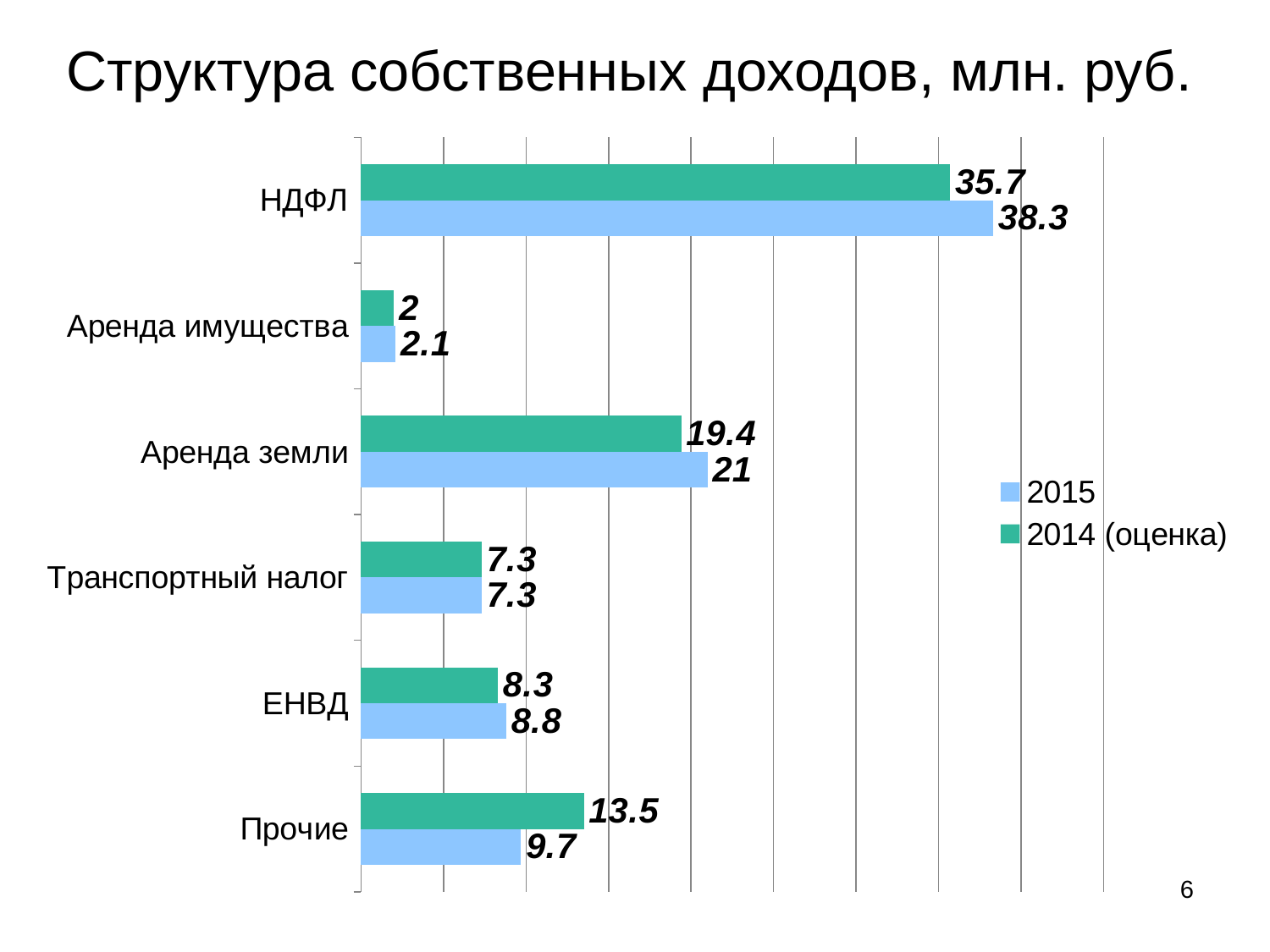
What is the difference between the 2014 (оценка) and 2015 values for Прочие? 3.8 What is the 2014 (оценка) value for ЕНВД? 8.3 What is the 2015 value for Прочие? 9.7 How many series does the legend list? 2 What kind of chart is shown on the slide? Bar chart Which category has the highest 2015 value? НДФЛ Which is larger for Аренда земли: the 2015 value or the 2014 (оценка) value? 2015 What is the 2015 value for НДФЛ? 38.3 What is the 2014 (оценка) value for Аренда земли? 19.4 What is the difference between the 2015 and 2014 (оценка) values for НДФЛ? 2.6 Which category has the lowest 2014 (оценка) value? Аренда имущества How many categories are shown on the chart? 6